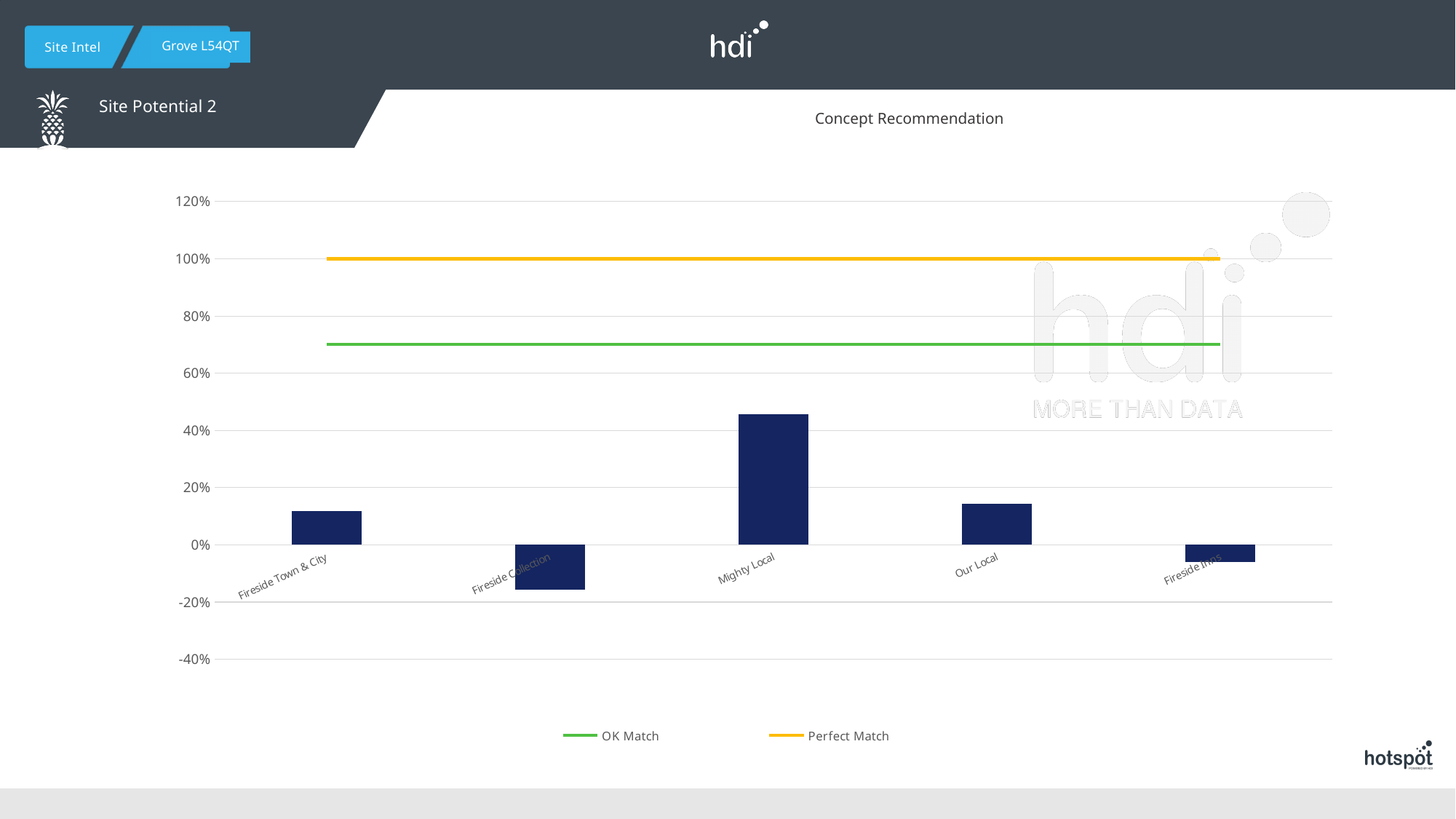
How many series does the legend list? 2 Which concept has the highest bar? Mighty Local How many concept categories are plotted on the x axis? 5 Is the value for Fireside Collection greater or less than 0%? less Is the value for Our Local greater or less than 20%? less Is the value for Mighty Local greater or less than 40%? greater What is the title of the chart? Concept Recommendation Which concept has the lowest bar? Fireside Collection At what level is the Perfect Match line drawn? 100% Which is larger, the value for Mighty Local or the value for Our Local? Mighty Local What kind of chart is shown on the slide? combination bar and line chart Which is larger, the value for Fireside Inns or the value for Fireside Collection? Fireside Inns